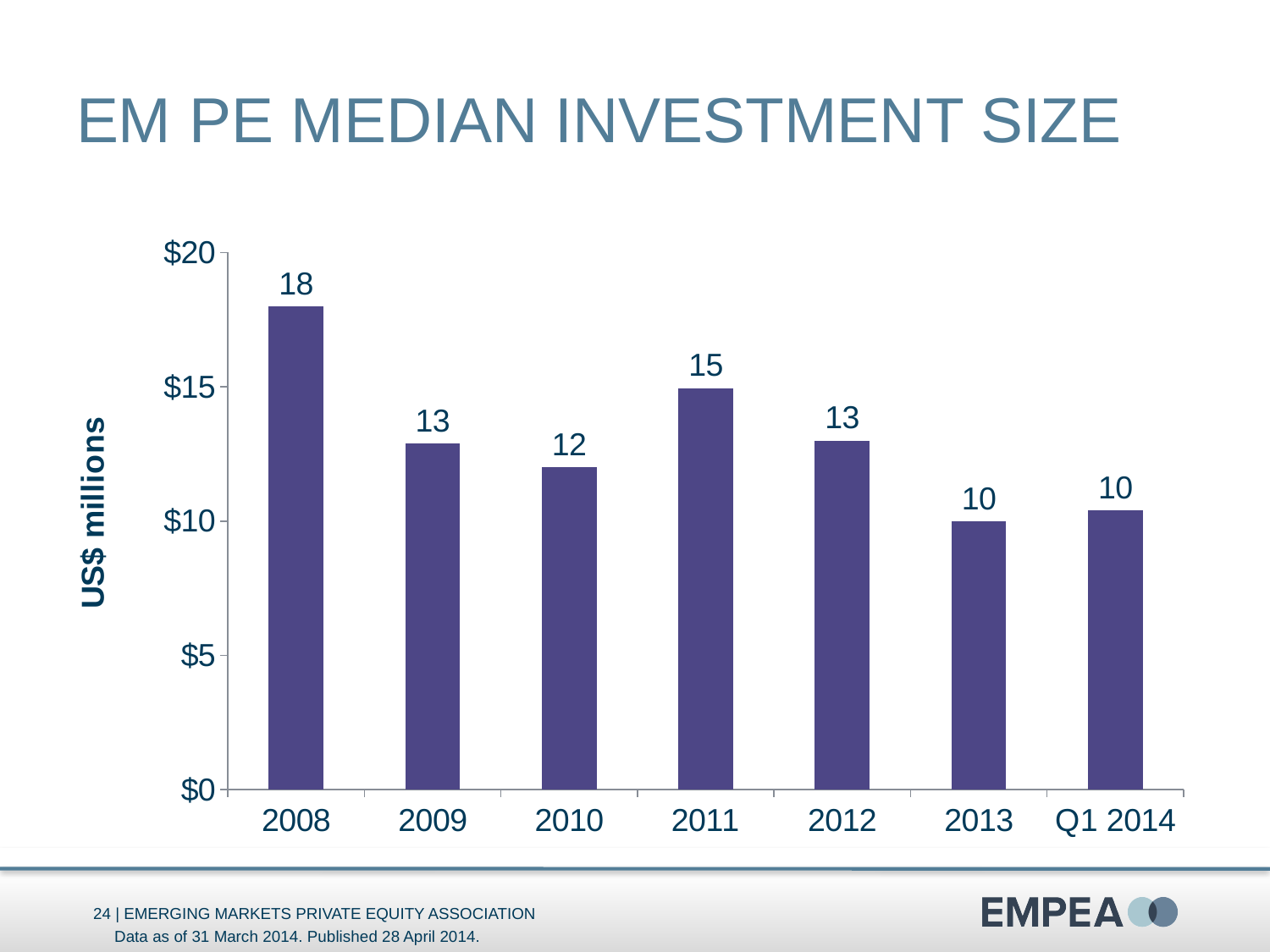
What is the label of the y axis? US$ millions Which is larger, the median investment size in 2009 or in 2010? 2009 What is the difference between the median investment size in 2012 and in 2013? 3 What is the median investment size for 2008? 18 Which year has the highest median investment size? 2008 Is the value for 2011 greater or less than $10? greater What is the median investment size for Q1 2014? 10 What kind of chart is shown on the slide? bar chart How many periods are shown on the x axis? 7 What is the median investment size for 2010? 12 What is the median investment size for 2011? 15 What is the difference between the median investment size in 2008 and in 2011? 3